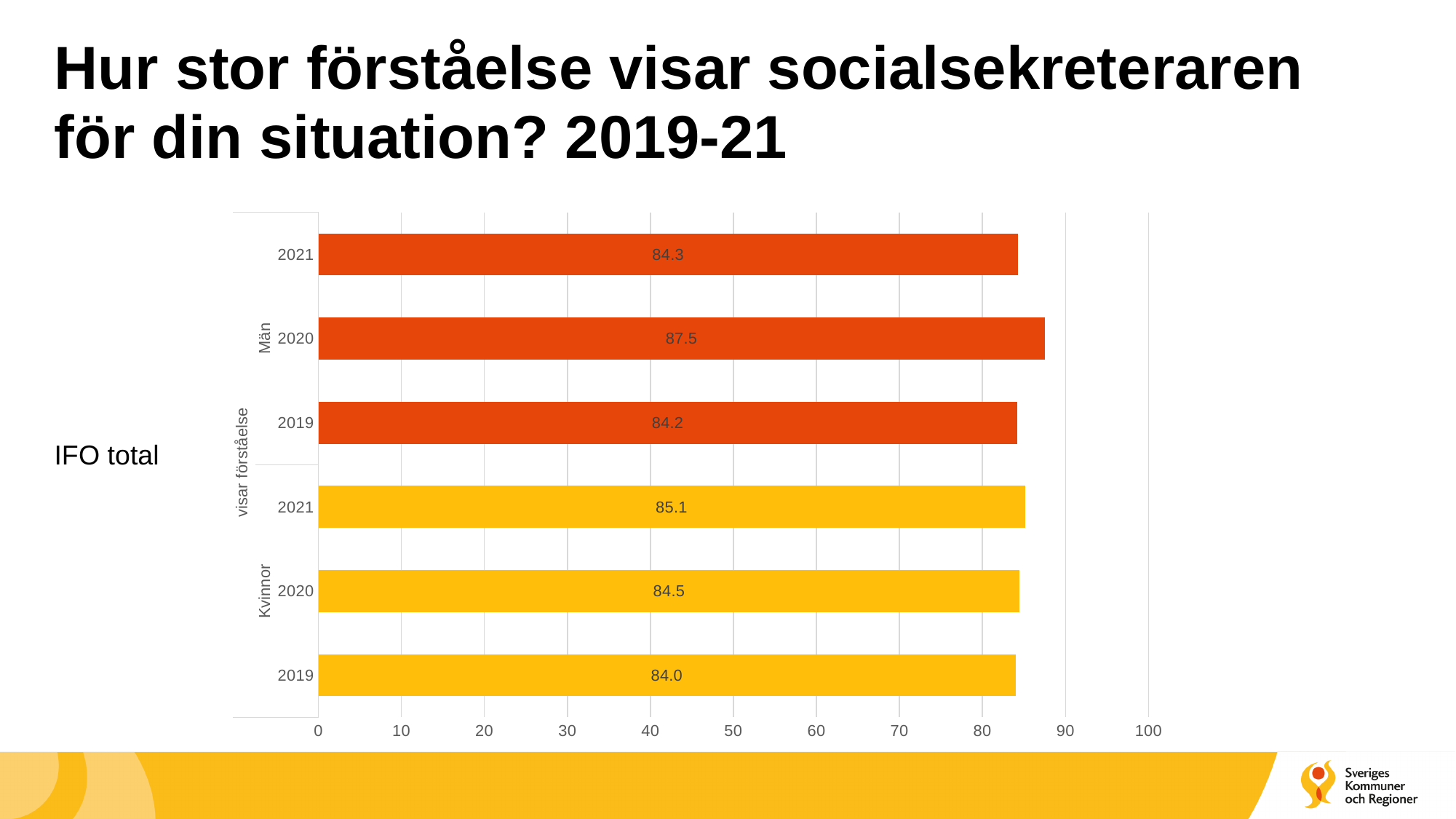
What kind of chart is shown on the slide? bar chart What is the value for Kvinnor in 2021? 85.1 Is the value for Kvinnor in 2020 greater or less than 80? greater What is the value for Kvinnor in 2019? 84.0 Which bar has the lowest value? Kvinnor 2019 What is the difference between the Män 2020 value and the Män 2021 value? 3.2 What is the value for Män in 2020? 87.5 Which is larger, the Kvinnor 2021 value or the Män 2021 value? Kvinnor 2021 How many bars are shown in the chart? 6 What colour are the bars for Kvinnor? yellow Which bar has the highest value? Män 2020 What is the value for Män in 2019? 84.2